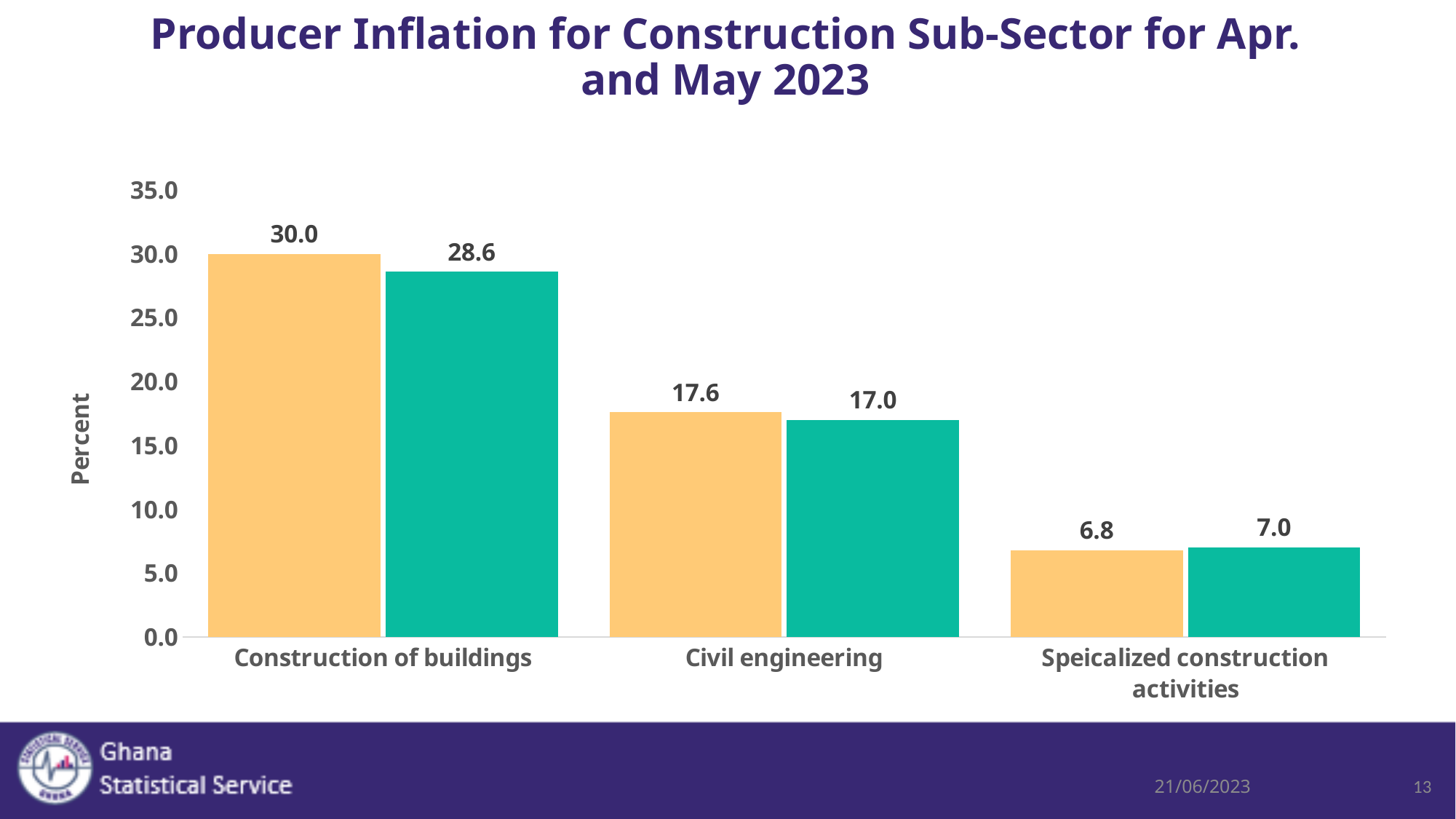
What is the label of the vertical axis? Percent What value is shown on the orange bar for Speicalized construction activities? 6.8 For Speicalized construction activities, which bar is larger, the orange or the teal? teal What value is shown on the teal bar for Construction of buildings? 28.6 What value is shown on the teal bar for Civil engineering? 17.0 Which category has the lowest value in the chart? Speicalized construction activities What is the difference between the orange and teal bars for Construction of buildings? 1.4 How many categories are shown on the x axis? 3 Which category has the highest value in the chart? Construction of buildings What is the difference between the orange bar for Civil engineering and the orange bar for Speicalized construction activities? 10.8 What value is shown on the orange bar for Construction of buildings? 30.0 What type of chart is shown on the slide? bar chart